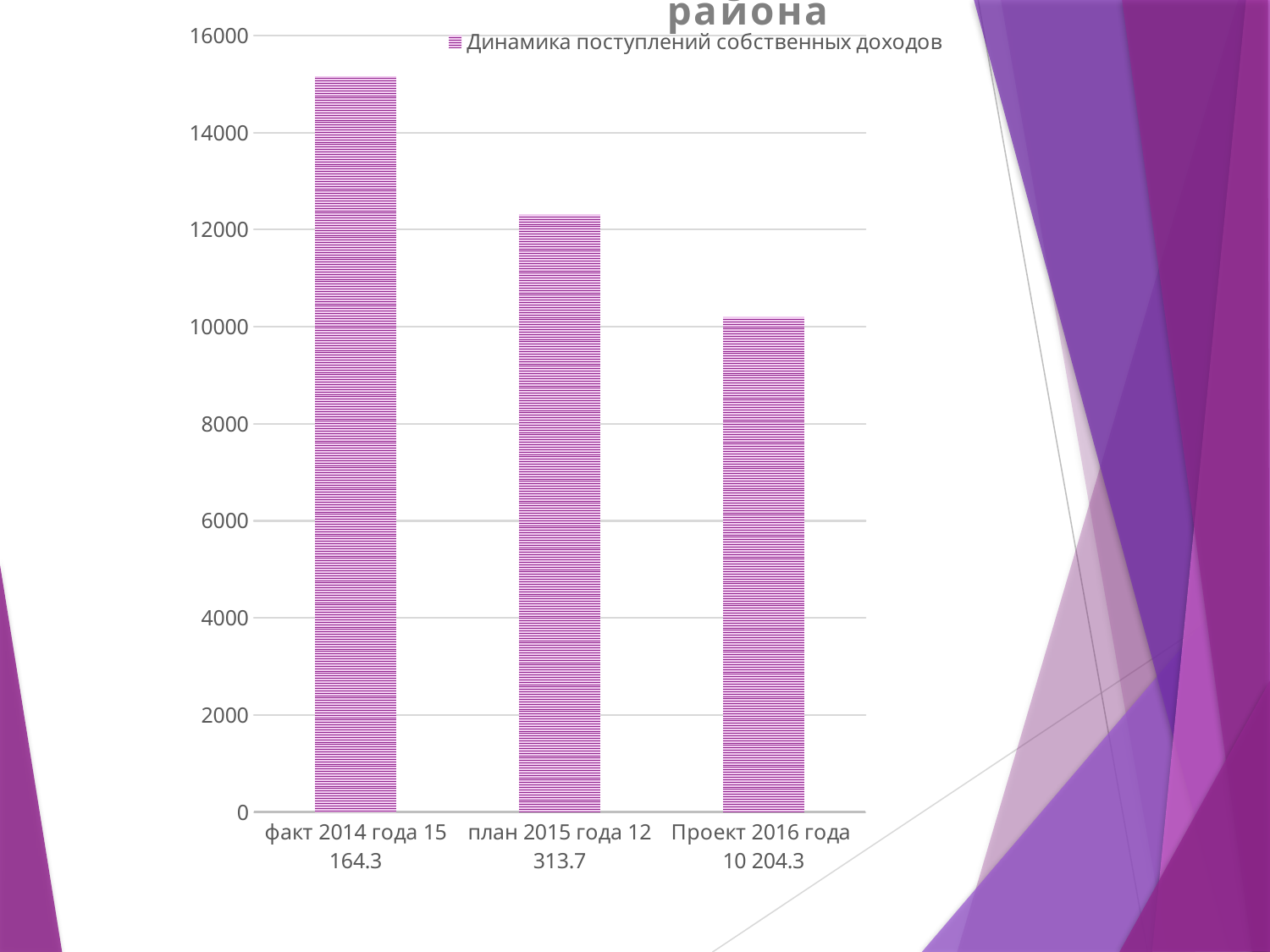
Which category has the lowest bar? Проект 2016 года What value is printed in the category label for план 2015 года? 12 313.7 How many bars (categories) does the chart show? 3 What is the series name shown in the legend? Динамика поступлений собственных доходов Which is larger, the bar for план 2015 года or the bar for Проект 2016 года? план 2015 года Do the values rise or fall from left to right along the x axis? fall What kind of chart is shown on the slide? bar chart Is the value for факт 2014 года greater or less than 14000? greater Which category has the highest bar? факт 2014 года How many series does the legend list? 1 What value is printed in the category label for факт 2014 года? 15 164.3 Is the value for Проект 2016 года greater or less than 12000? less